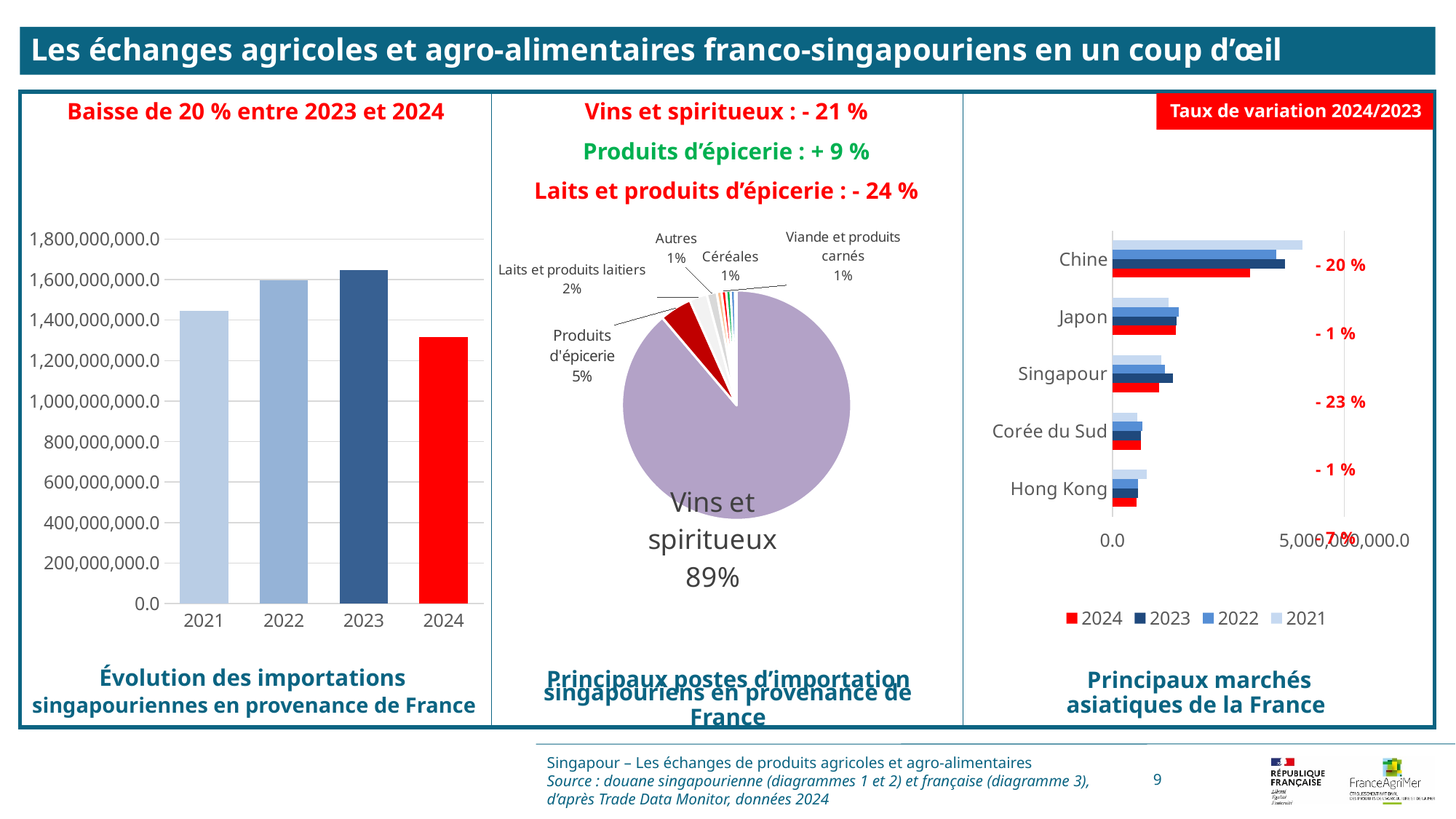
In the right chart 'Principaux marchés asiatiques de la France', how many series does the legend list? 4 In the left chart 'Évolution des importations singapouriennes en provenance de France', is the value for 2023 greater or less than 1,600,000,000.0? greater In the left chart 'Évolution des importations singapouriennes en provenance de France', how many years are plotted? 4 In the left chart 'Évolution des importations singapouriennes en provenance de France', is the value for 2024 greater or less than 1,400,000,000.0? less In the left chart 'Évolution des importations singapouriennes en provenance de France', which year has the highest value? 2023 What kind of chart is the left chart, 'Évolution des importations singapouriennes en provenance de France'? bar chart In the middle pie chart 'Principaux postes d'importation singapouriens en provenance de France', how many slices are labelled? 6 In the middle pie chart 'Principaux postes d'importation singapouriens en provenance de France', what share does 'Vins et spiritueux' represent? 89% In the right chart 'Principaux marchés asiatiques de la France', which market has the highest values? Chine In the middle pie chart 'Principaux postes d'importation singapouriens en provenance de France', what share does 'Produits d'épicerie' represent? 5% In the right chart 'Principaux marchés asiatiques de la France', is the 2024 value for Chine greater or less than 5,000,000,000.0? less In the left chart 'Évolution des importations singapouriennes en provenance de France', which year has the lowest value? 2024